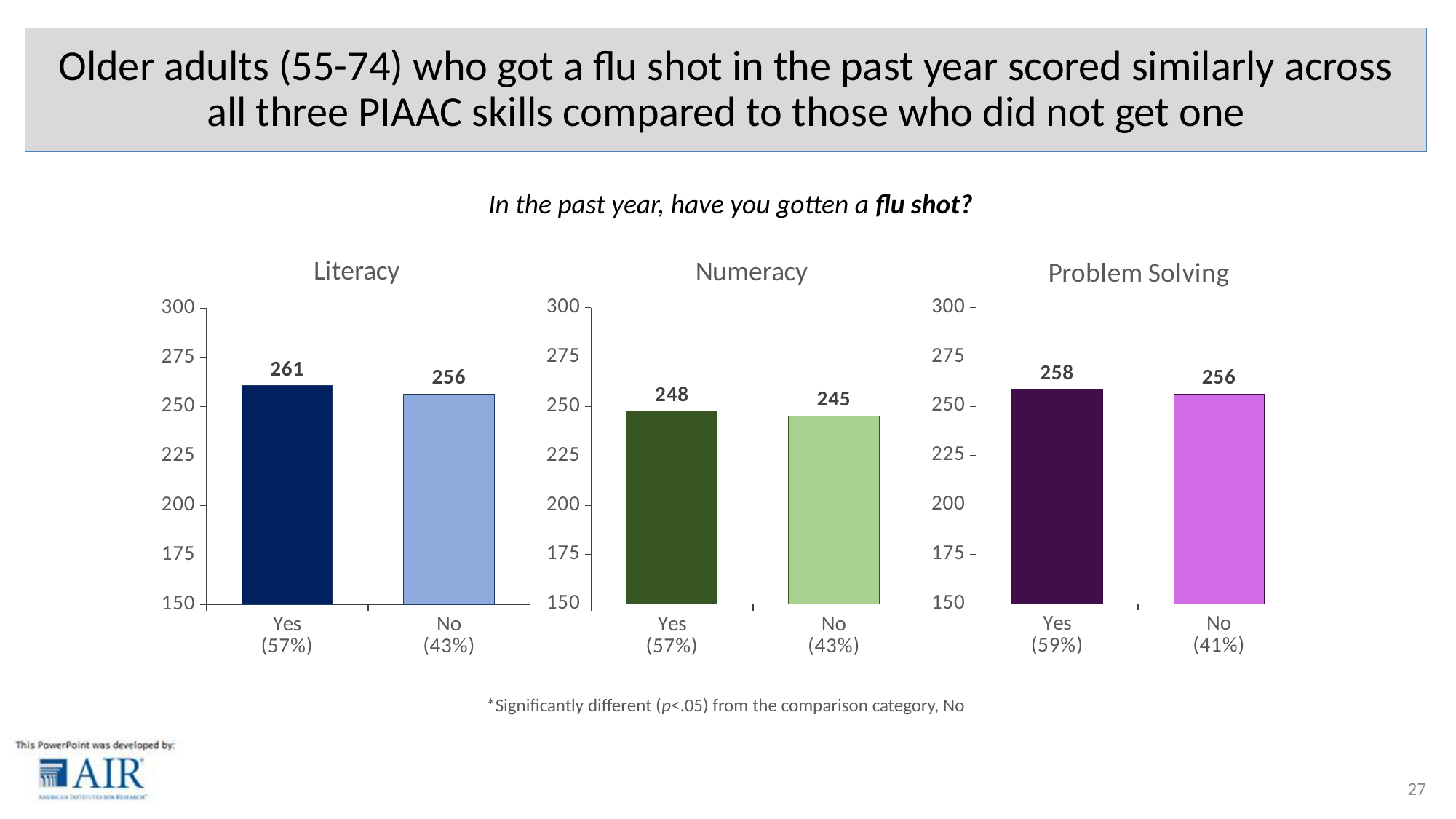
In the Literacy chart, what is the difference between the Yes and No values? 5 In the Numeracy chart, is the value for Yes greater or less than 250? less In the Numeracy chart, what is the difference between the Yes and No values? 3 In the Problem Solving chart, what is the value for No? 256 In the Numeracy chart, what is the value for Yes? 248 What kind of chart is the Problem Solving chart? bar chart How many categories does the Literacy chart show? 2 In the Problem Solving chart, what is the difference between the Yes and No values? 2 In the Problem Solving chart, what is the value for Yes? 258 In the Literacy chart, what is the value for Yes? 261 In the Literacy chart, what is the value for No? 256 In the Numeracy chart, what is the value for No? 245